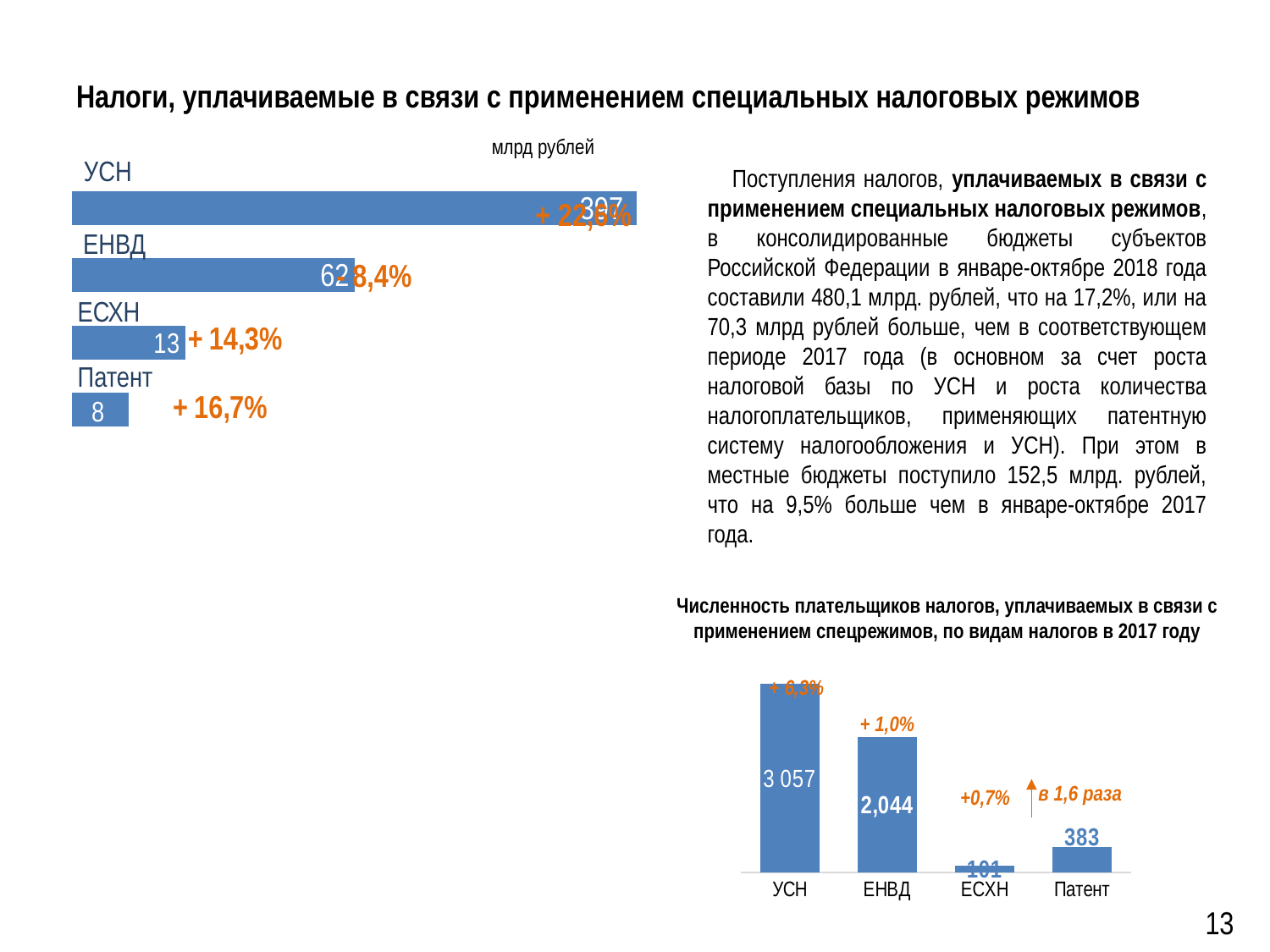
In the left chart (млрд рублей), how many categories are shown? 4 What kind of chart is the chart on the left of the slide (the one in млрд рублей)? bar chart In the chart titled 'Численность плательщиков налогов, уплачиваемых в связи с применением спецрежимов, по видам налогов в 2017 году', which category has the lowest value? ЕСХН In the chart titled 'Численность плательщиков налогов, уплачиваемых в связи с применением спецрежимов, по видам налогов в 2017 году', what is the value for УСН? 3 057 In the left chart (млрд рублей), what is the value for ЕСХН? 13 What unit is stated above the left chart? млрд рублей In the left chart (млрд рублей), which category has the highest value? УСН In the left chart (млрд рублей), what is the difference between the values for ЕСХН and Патент? 5 In the left chart (млрд рублей), which category has the lowest value? Патент In the left chart (млрд рублей), which is larger: the value for ЕНВД or the value for ЕСХН? ЕНВД In the left chart (млрд рублей), what is the value for Патент? 8 In the chart titled 'Численность плательщиков налогов, уплачиваемых в связи с применением спецрежимов, по видам налогов в 2017 году', what is the value for Патент? 383